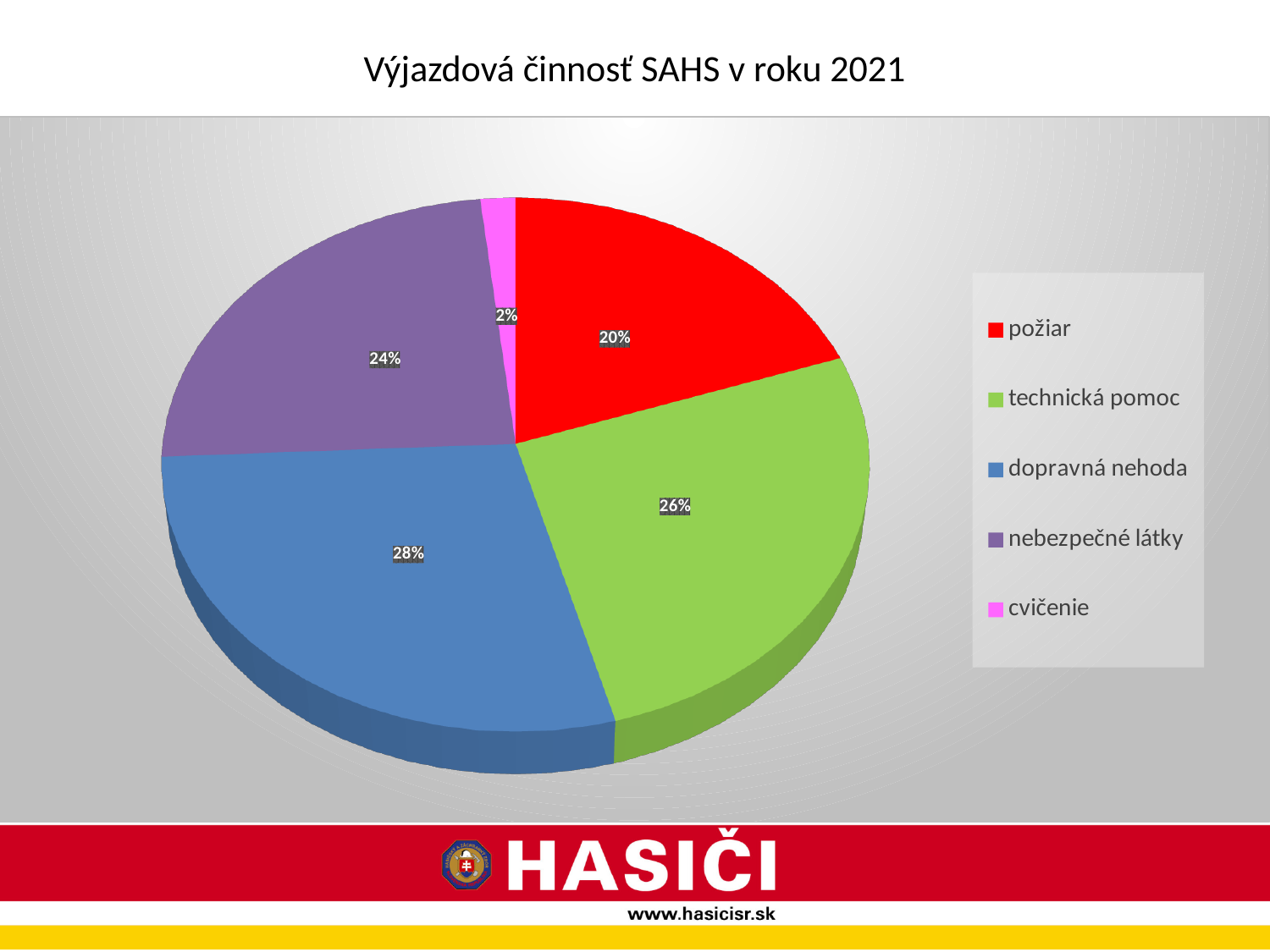
How many categories does the legend list? 5 What share of the pie does 'technická pomoc' represent? 26% Which category has the largest slice of the pie? dopravná nehoda What share of the pie does 'cvičenie' represent? 2% Which is larger, the share for 'technická pomoc' or the share for 'nebezpečné látky'? technická pomoc What is the difference in percentage points between 'dopravná nehoda' and 'požiar'? 8 What share of the pie does 'požiar' represent? 20% What is the title of the chart? Výjazdová činnosť SAHS v roku 2021 What kind of chart is shown on the slide? pie chart Which category has the smallest slice of the pie? cvičenie